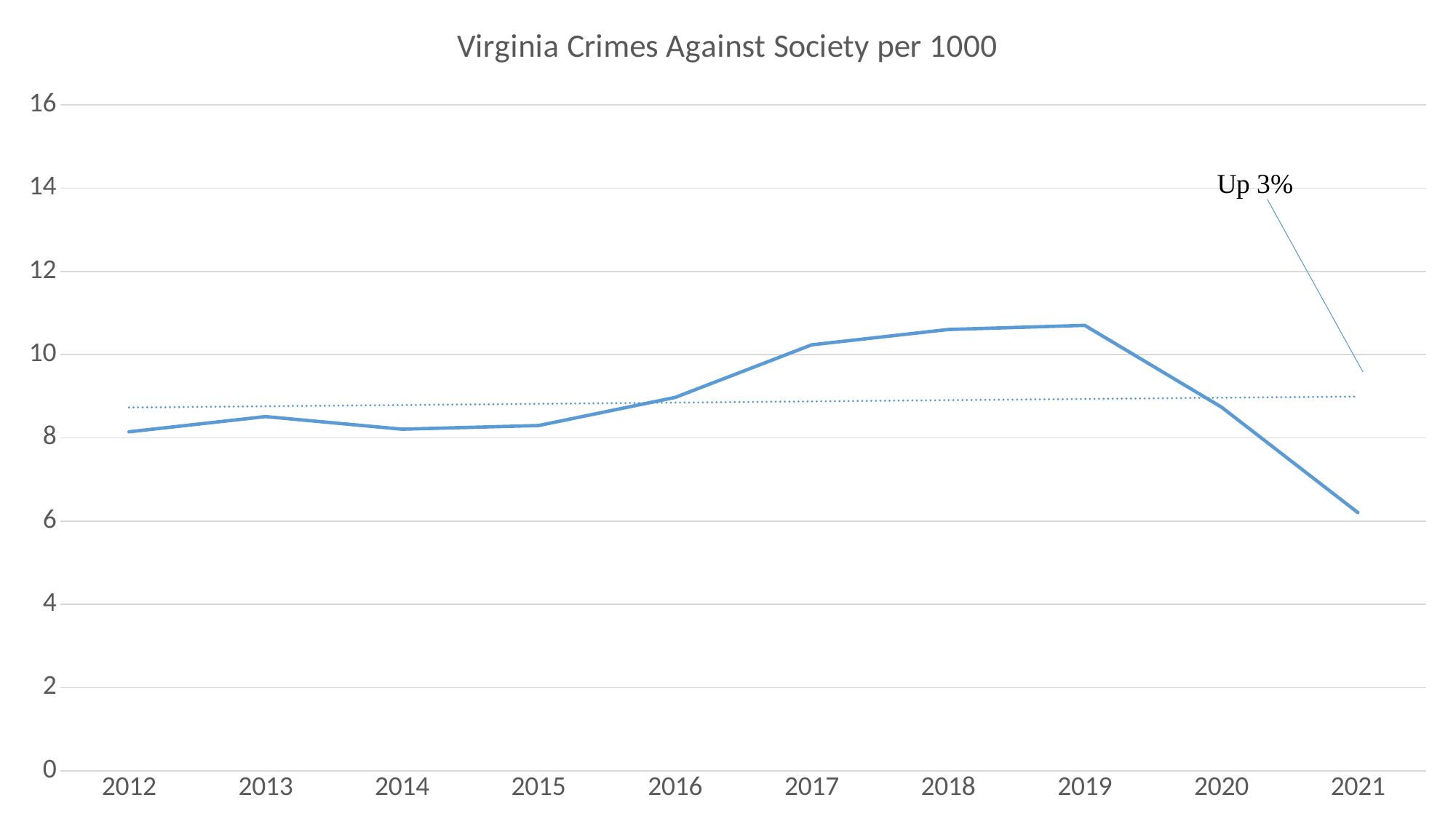
Is the value for 2021 greater or less than 8? less What is the title of the chart? Virginia Crimes Against Society per 1000 Is the value for 2013 greater or less than 6? greater Do the values rise or fall from 2015 to 2019? rise Which year has the lowest value? 2021 Do the values rise or fall from 2019 to 2021? fall What kind of chart is shown on the slide? line chart What does the text annotation near the dotted trend line say? Up 3% Is the value for 2014 greater or less than 10? less How many years are plotted along the x axis? 10